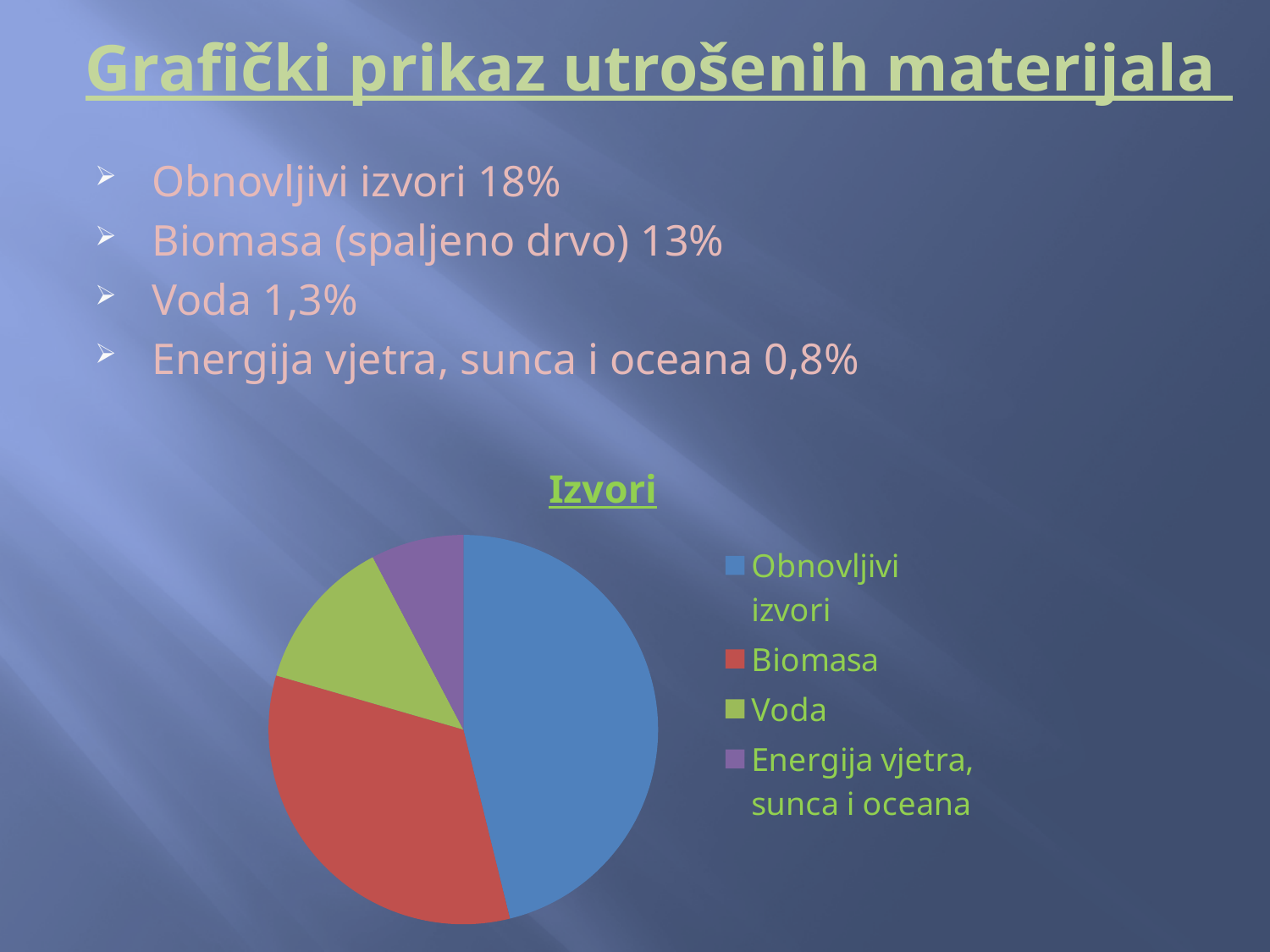
Which slice is larger, Voda or Energija vjetra, sunca i oceana? Voda Which colour represents Biomasa in the pie chart? red How many entries does the chart legend list? 4 How many slices does the pie chart have? 4 What kind of chart is shown on the slide? pie chart Which slice is larger, Obnovljivi izvori or Biomasa? Obnovljivi izvori What is the title of the chart? Izvori Which slice is larger, Biomasa or Voda? Biomasa Which category has the largest slice in the pie chart? Obnovljivi izvori Which category has the smallest slice in the pie chart? Energija vjetra, sunca i oceana